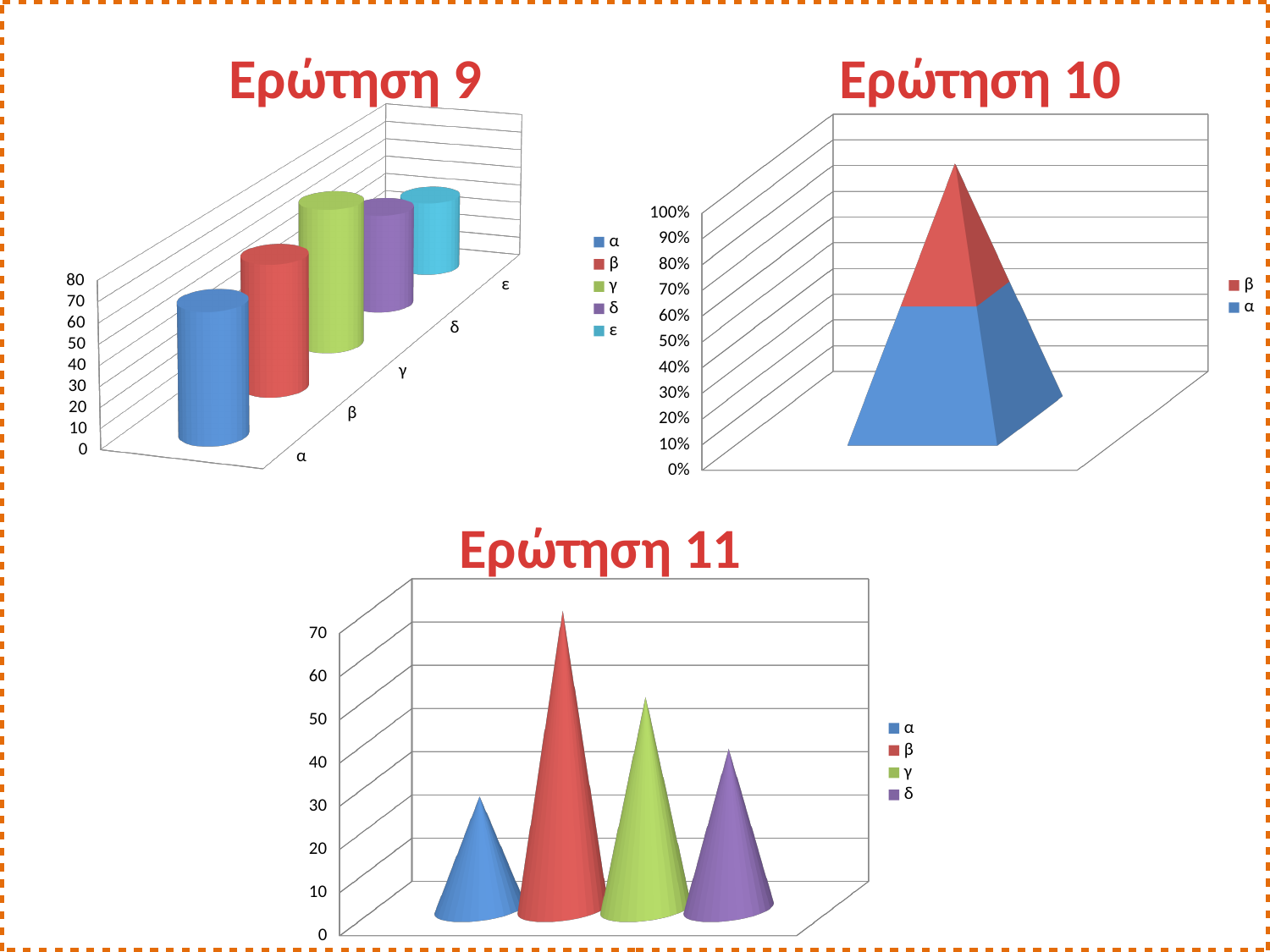
What kind of chart is the Ερώτηση 9 chart? bar chart How many series does the legend of the Ερώτηση 10 chart list? 2 How many categories are shown in the Ερώτηση 11 chart? 4 In the Ερώτηση 9 chart, is the value for α greater or less than 80? less In the Ερώτηση 10 chart, which colour represents series α? blue How many series does the legend of the Ερώτηση 9 chart list? 5 In the Ερώτηση 11 chart, is the value for α greater or less than 40? less In the Ερώτηση 11 chart, which category has the highest value? β How many categories are shown in the Ερώτηση 9 chart? 5 In the Ερώτηση 11 chart, which category has the lowest value? α In the Ερώτηση 11 chart, is the value for β greater or less than 50? greater